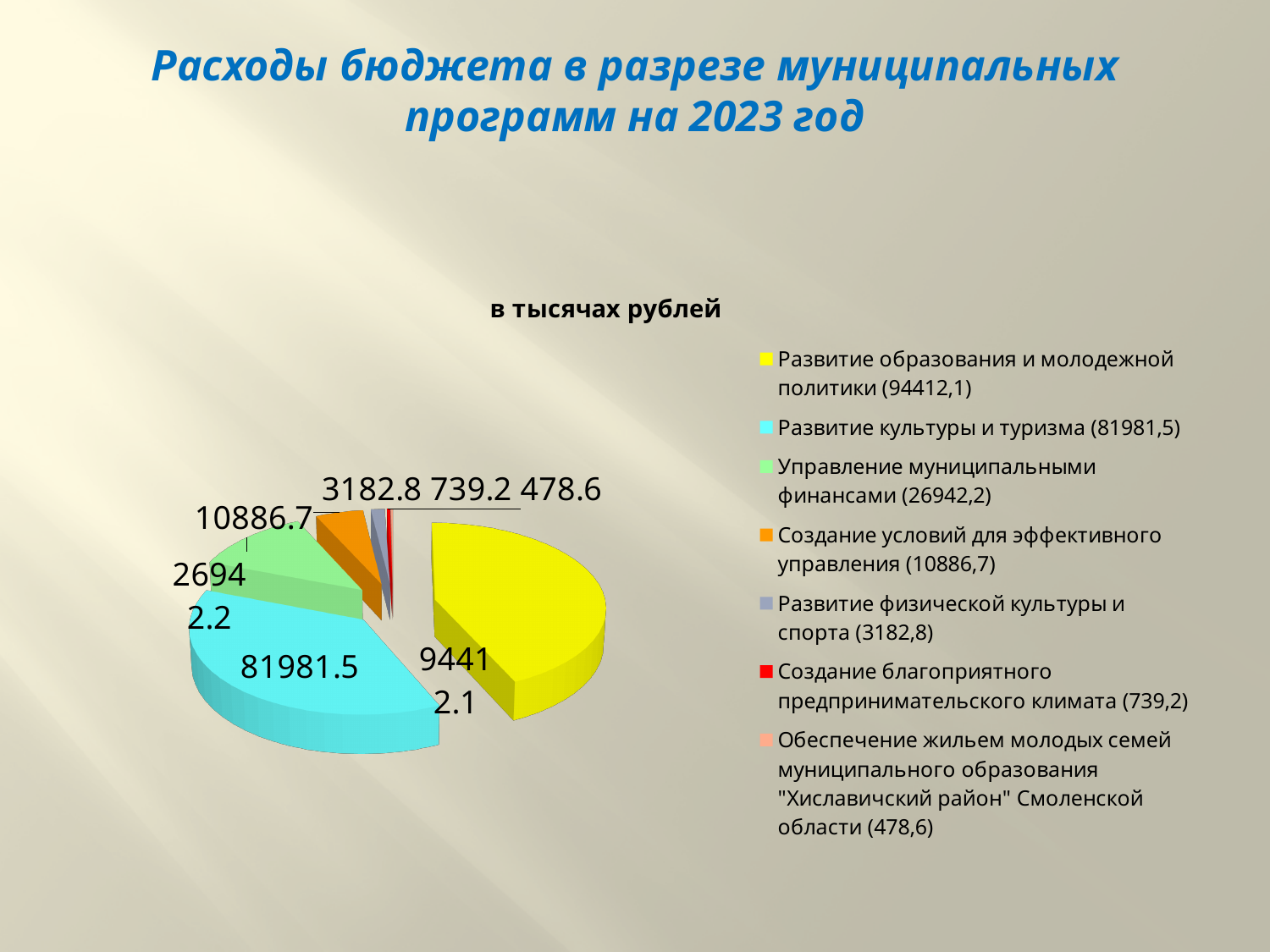
Which category has the smallest slice of the pie? Обеспечение жильем молодых семей муниципального образования "Хиславичский район" Смоленской области Which category has the largest slice of the pie? Развитие образования и молодежной политики What is the difference between the values for "Создание условий для эффективного управления" (10886.7) and "Развитие физической культуры и спорта" (3182.8)? 7703.9 How many entries does the legend of the pie chart list? 7 What is the value for "Развитие культуры и туризма"? 81981.5 What kind of chart is shown on the slide? pie chart What is the value for "Обеспечение жильем молодых семей" according to the legend? 478,6 What is the value for "Создание условий для эффективного управления"? 10886.7 How many slices (categories) does the pie chart have? 7 Which is larger: the value for "Управление муниципальными финансами" or the value for "Создание условий для эффективного управления"? Управление муниципальными финансами What is the value for "Развитие физической культуры и спорта"? 3182.8 What is the title printed above the pie chart? в тысячах рублей